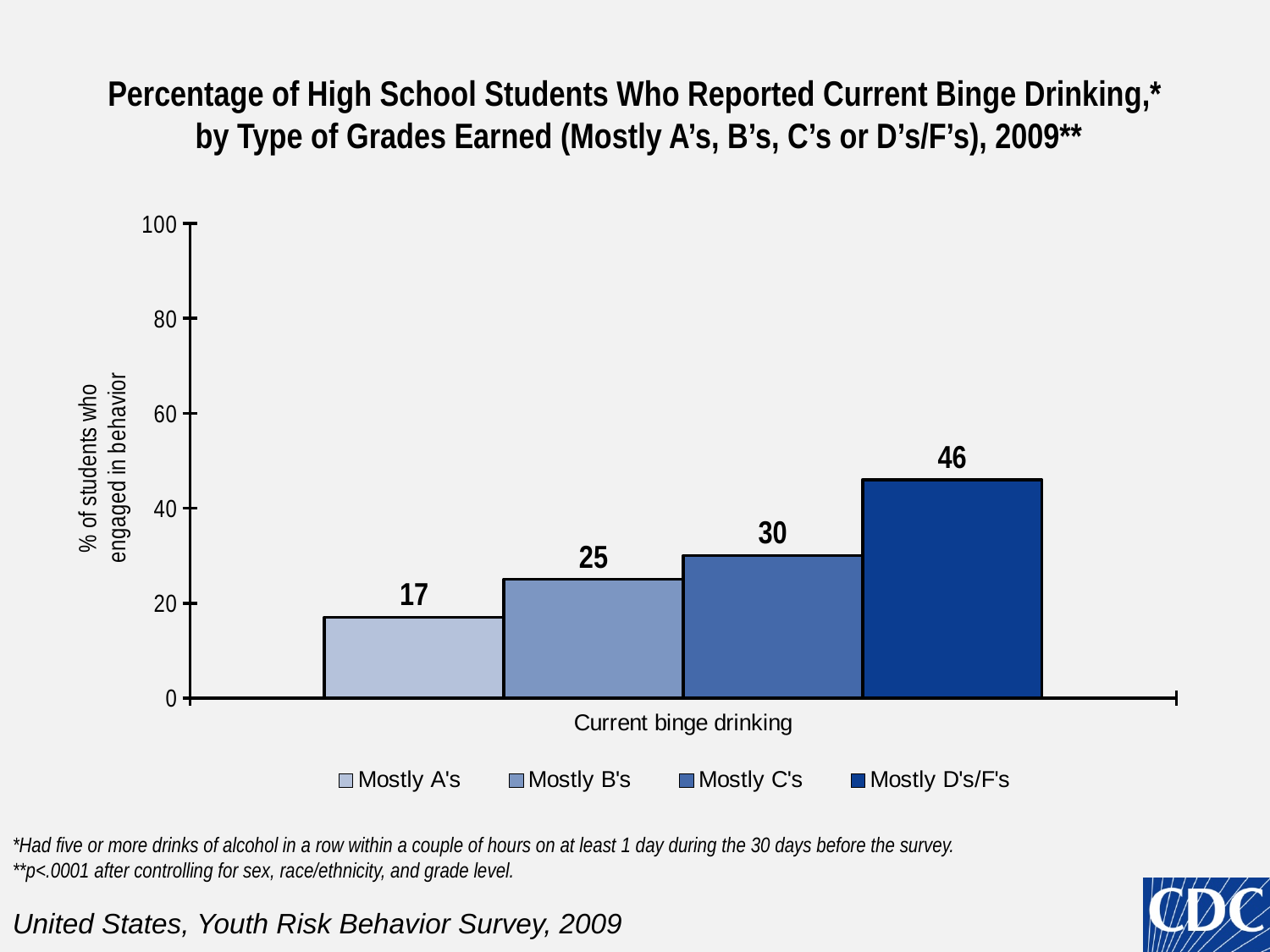
Which grade group has the highest percentage of current binge drinking? Mostly D's/F's How many series does the legend list? 4 What is the value for Mostly D's/F's? 46 Which is larger, the value for Mostly B's or Mostly C's? Mostly C's What is the difference between the values for Mostly D's/F's and Mostly A's? 29 What is the label on the y axis? % of students who engaged in behavior What is the value for Mostly B's? 25 What is the value for Mostly C's? 30 Is the value for Mostly D's/F's greater or less than 40? greater What kind of chart is shown on the slide? Bar chart Which grade group has the lowest percentage of current binge drinking? Mostly A's What percentage of students with Mostly A's reported current binge drinking? 17